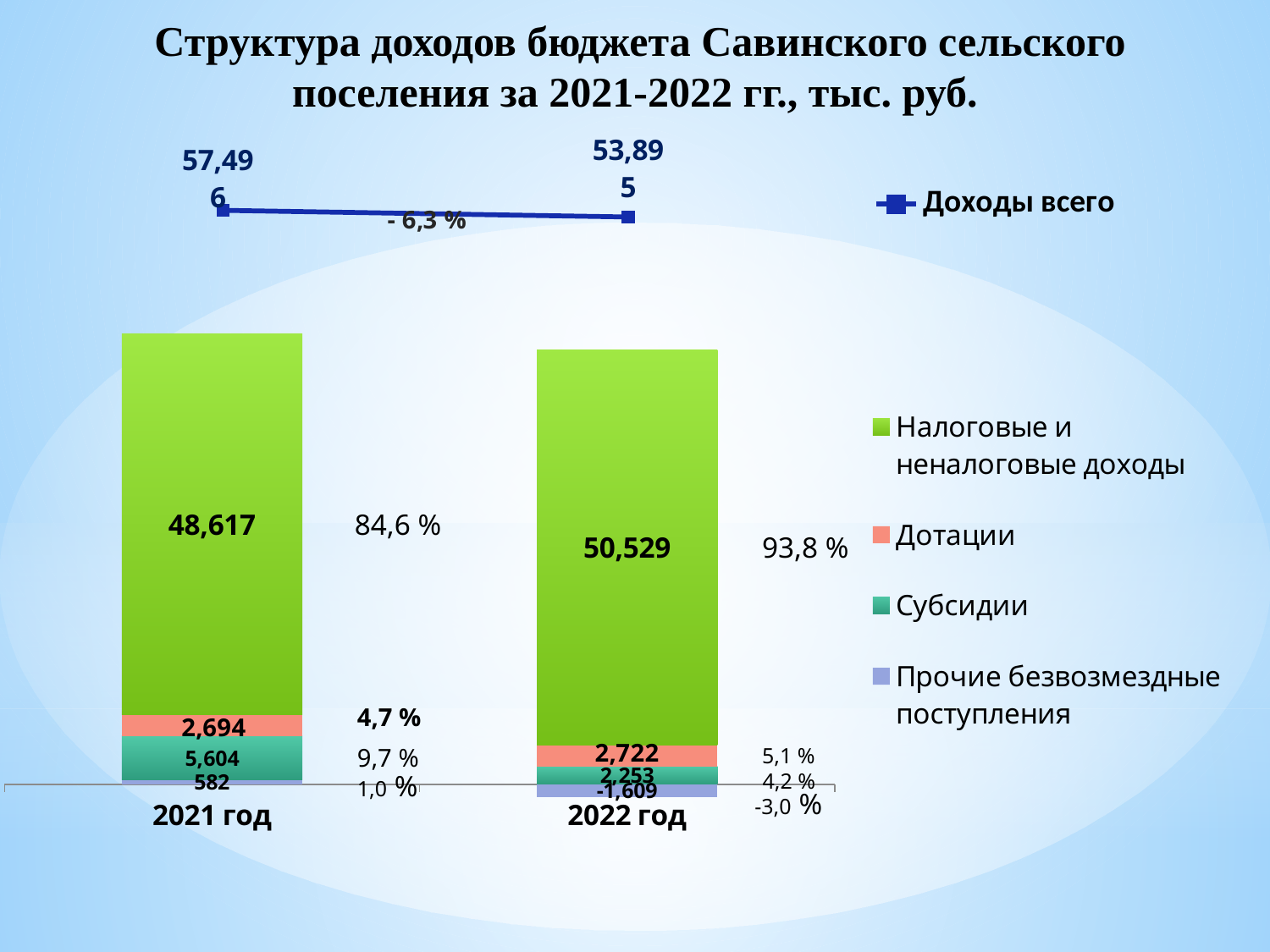
What is the value of Налоговые и неналоговые доходы for 2022 год? 50,529 What is the total of the 2022 год stacked bar (Доходы всего)? 53,895 By how much did Налоговые и неналоговые доходы increase from 2021 год to 2022 год? 1,912 Which year has the larger value for Субсидии, 2021 год or 2022 год? 2021 год What is the value of Прочие безвозмездные поступления for 2022 год? -1,609 What is the percentage change in Доходы всего shown on the line between 2021 год and 2022 год? - 6,3 % What is the value of Субсидии for 2021 год? 5,604 How many series does the legend of the stacked bar chart list? 4 Which series is the largest component of the 2021 год bar? Налоговые и неналоговые доходы What is the value of Налоговые и неналоговые доходы for 2021 год? 48,617 Does the Доходы всего line rise or fall from 2021 год to 2022 год? fall What share of the 2022 год budget revenue is Налоговые и неналоговые доходы, as labelled on the chart? 93,8 %